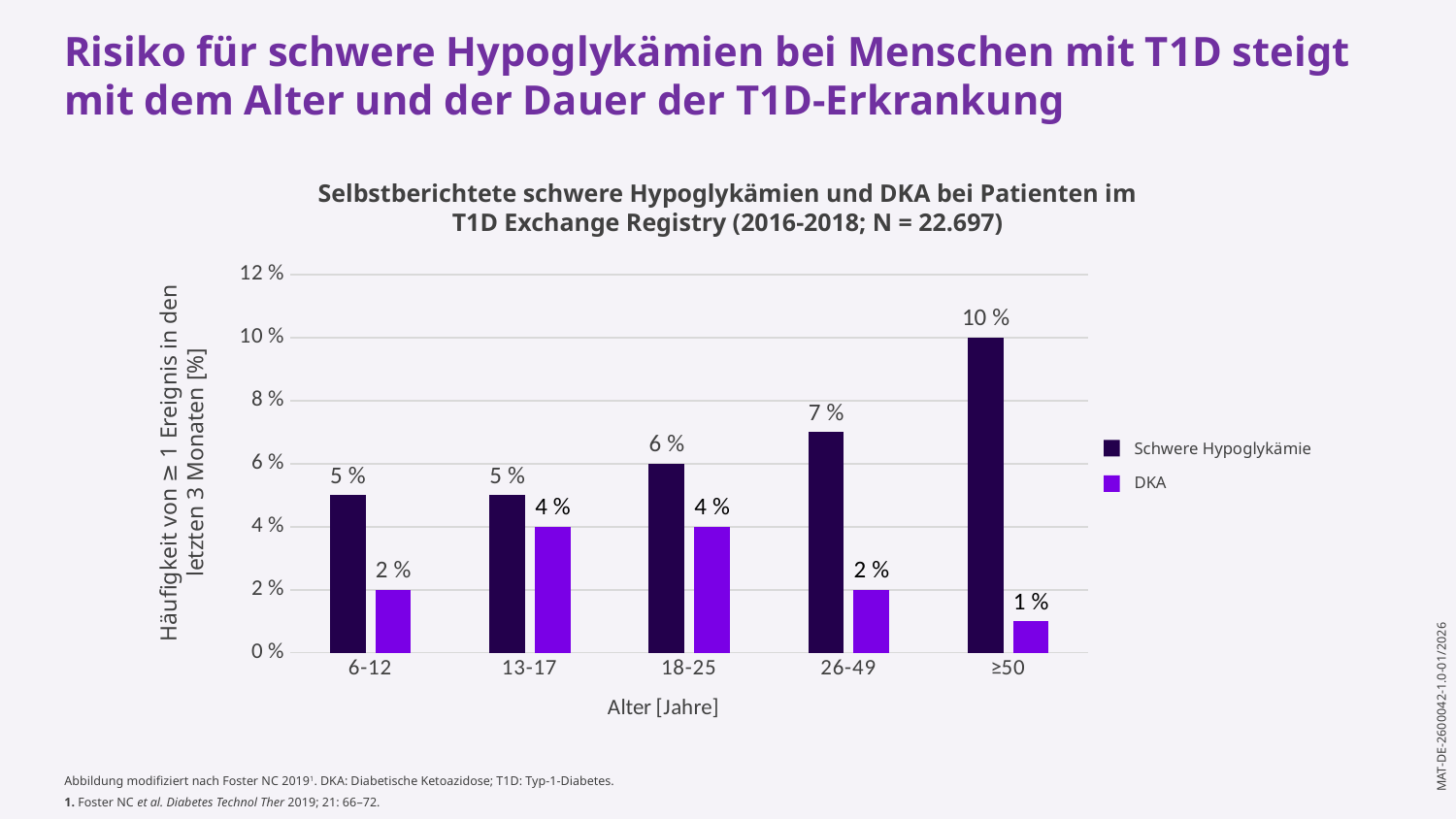
What is the difference between Schwere Hypoglykämie and DKA in the ≥50 age group? 9 % Which age group has the lowest value for DKA? ≥50 What is the value for DKA in the 13-17 age group? 4 % Which is larger in the 18-25 age group: Schwere Hypoglykämie or DKA? Schwere Hypoglykämie Which age group has the highest value for Schwere Hypoglykämie? ≥50 How many series does the legend list? 2 What is the label of the x axis? Alter [Jahre] What kind of chart is shown on the slide? Bar chart What is the value for Schwere Hypoglykämie in the ≥50 age group? 10 % How many age groups are shown on the x axis? 5 Do the values for Schwere Hypoglykämie rise or fall as age increases along the x axis? Rise What is the value for Schwere Hypoglykämie in the 26-49 age group? 7 %